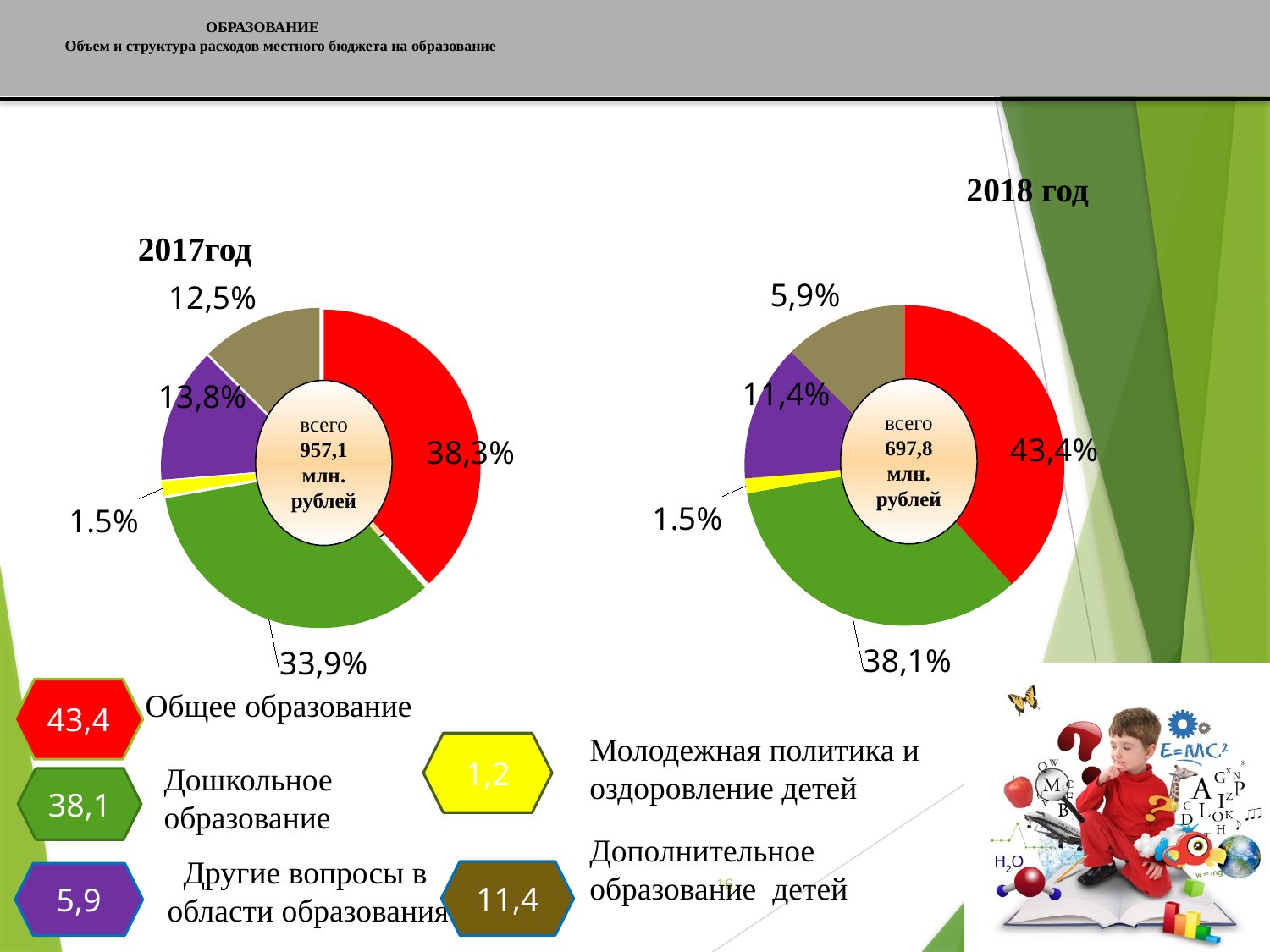
In the 2018 год pie chart, what is the share of the green slice (Дошкольное образование)? 38,1% In the 2017 год pie chart, which is larger: the purple slice or the brown slice? the purple slice In the 2018 год pie chart, what total amount is shown in the centre? 697,8 млн. рублей In the 2017 год pie chart, what is the share of the brown slice? 12,5% In the 2017 год pie chart, what is the difference between the red slice (38,3%) and the green slice (33,9%)? 4,4 percentage points In the 2018 год pie chart, what is the share of the largest slice? 43,4% In the 2017 год pie chart, what is the share of the smallest slice? 1.5% How many slices does the 2018 год pie chart have? 5 How many pie charts are shown on the slide? 2 What kind of chart is used for the 2017 год data? pie chart In the 2017 год pie chart, what is the share of the largest slice? 38,3% In the 2017 год pie chart, what total amount is shown in the centre? 957,1 млн. рублей